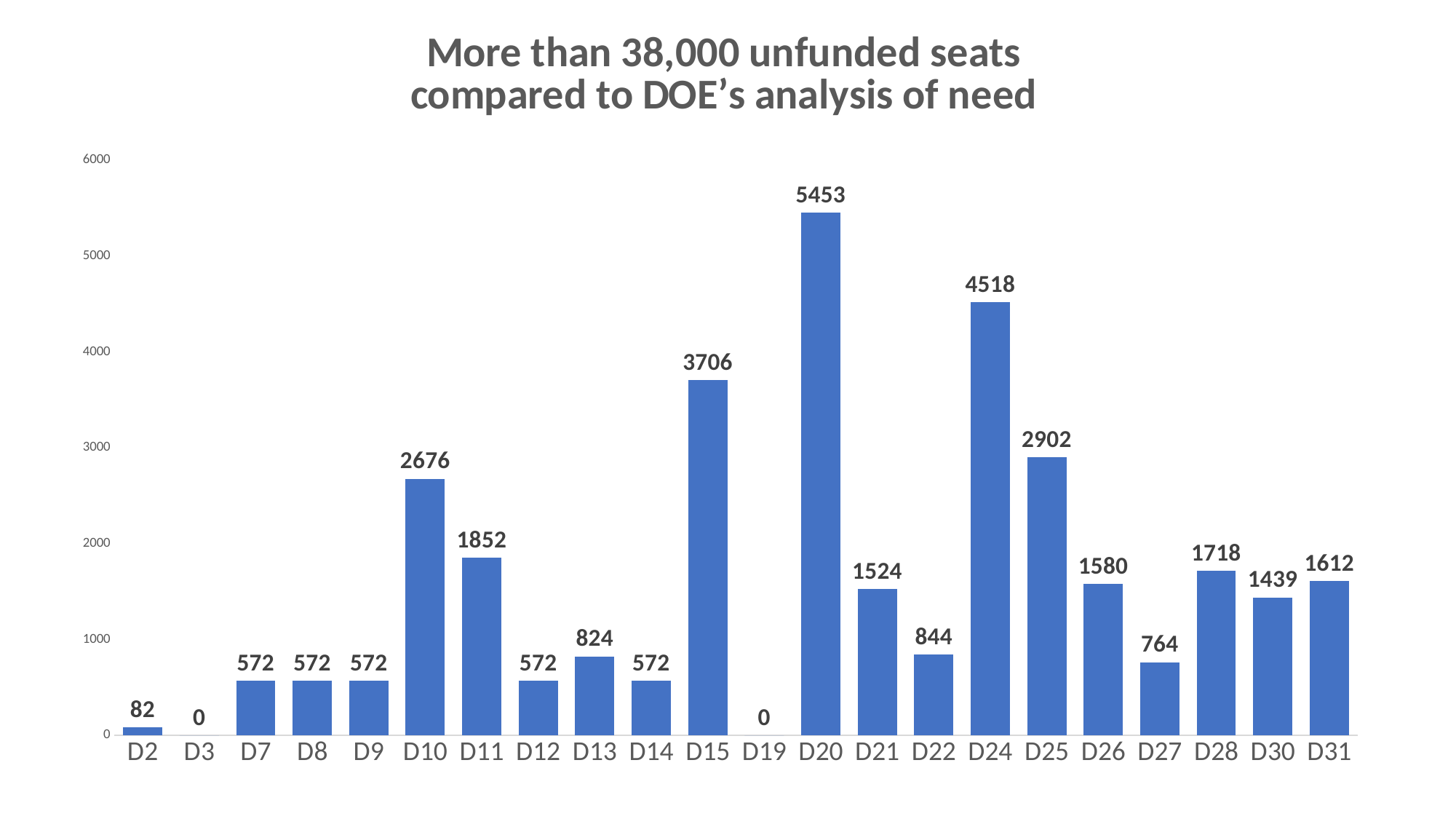
What is the difference between the values for D28 and D30? 279 Which is larger, the value for D25 or the value for D10? D25 What is the title of the chart? More than 38,000 unfunded seats compared to DOE's analysis of need What is the value for D27? 764 How many districts are shown on the x axis? 22 Which districts have a value of 0? D3 and D19 What is the value for D15? 3706 What is the difference between the values for D20 and D24? 935 What kind of chart is this? Bar chart Which district has the highest value? D20 What is the value for D2? 82 What is the value for D20? 5453